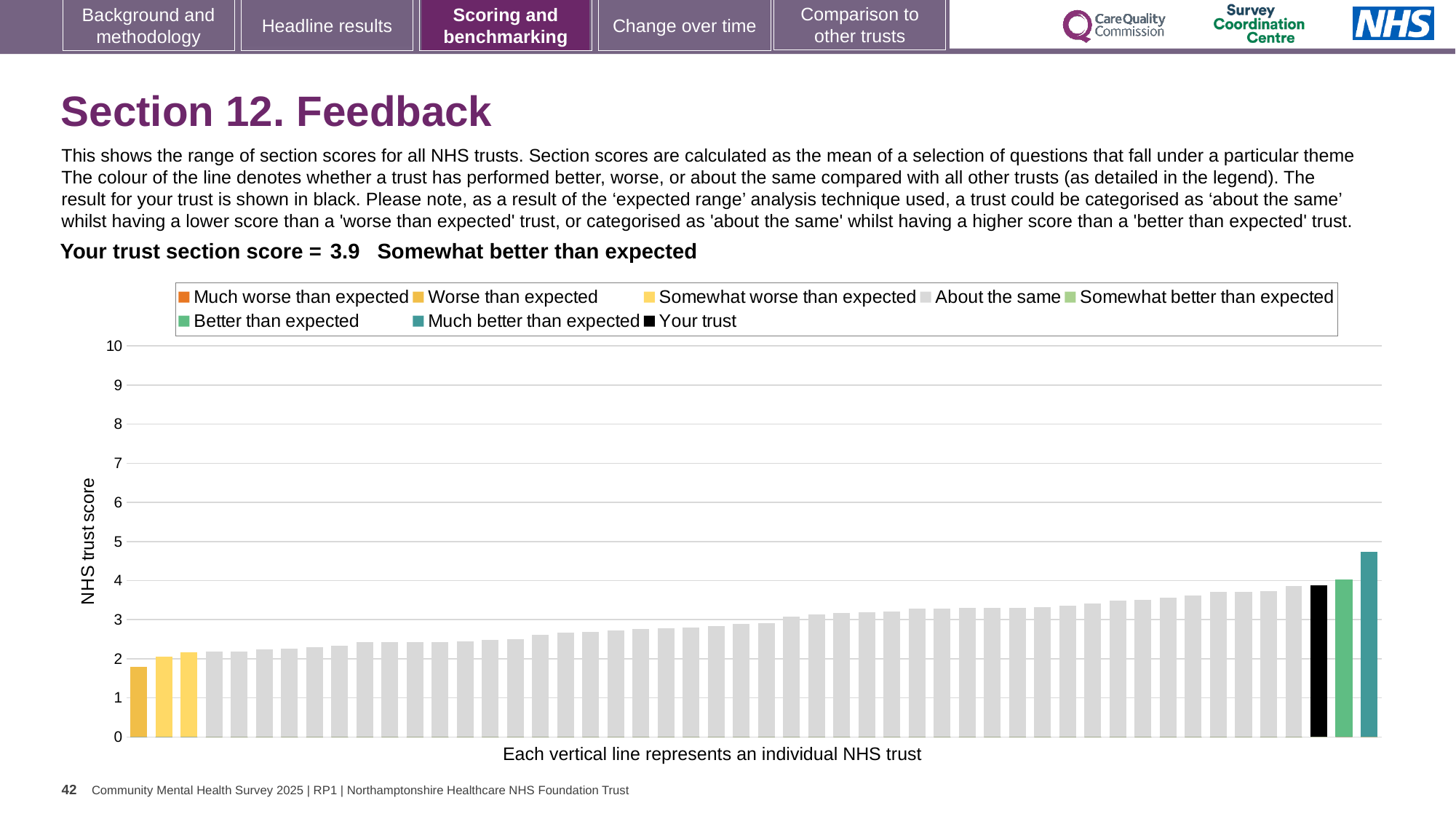
What is the label on the vertical axis of the chart? NHS trust score Is the value of the leftmost bar greater or less than 2? less Is the value of the black 'Your trust' bar greater or less than 5? less What is the highest value shown on the vertical axis? 10 Do the bar values rise or fall from left to right along the x axis? rise What kind of chart is shown on the slide? bar chart How many entries does the chart legend list? 8 Which category is your trust's section score placed in? Somewhat better than expected Is the value of the tallest bar (the rightmost teal bar) greater or less than 4? greater What is the section score for your trust shown on the slide? 3.9 Which is larger: the black 'Your trust' bar or the rightmost teal bar? the rightmost teal bar